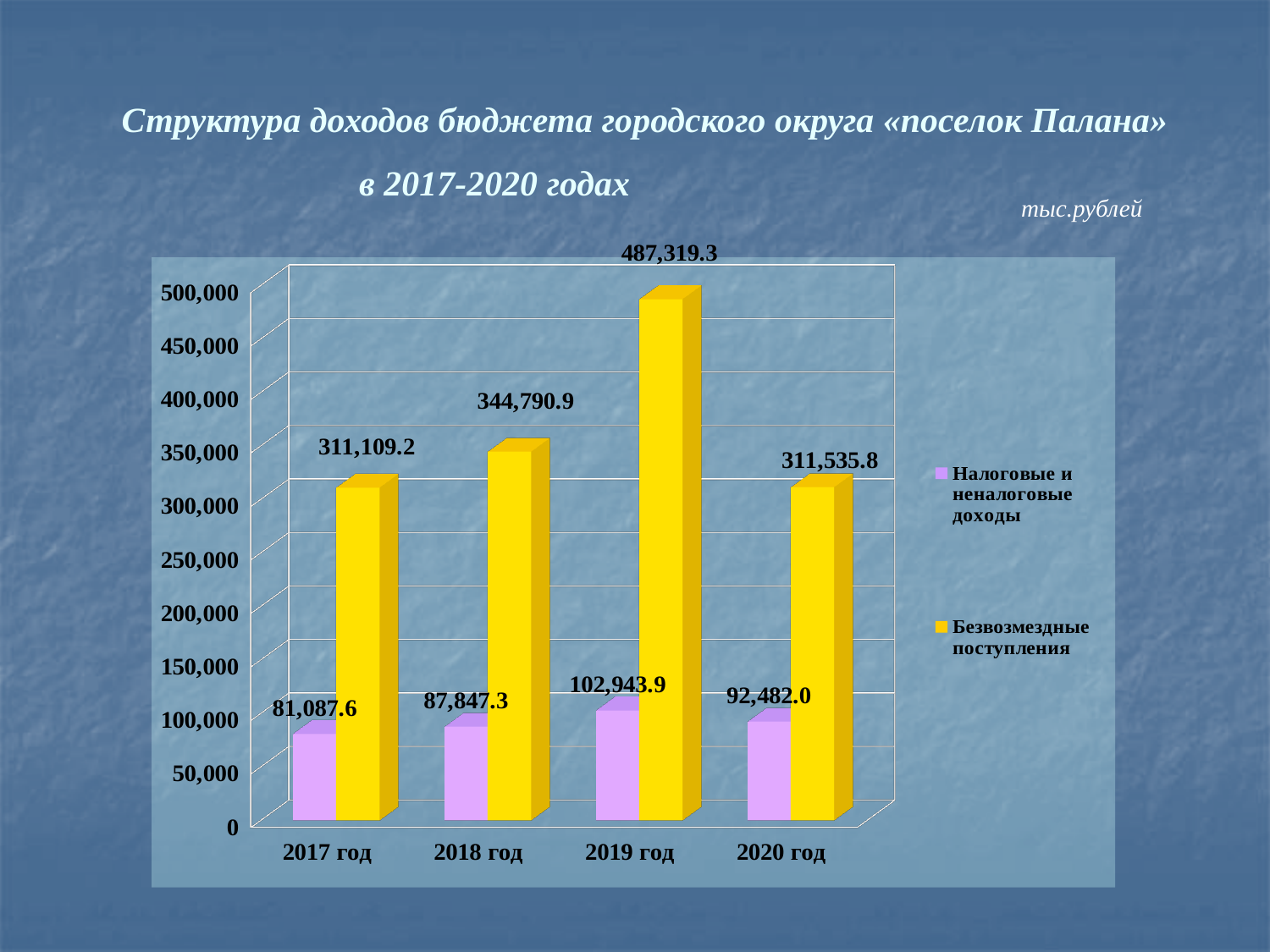
How many years are shown on the x axis? 4 What kind of chart is shown on the slide? Bar chart What is the value of Безвозмездные поступления for 2018 год? 344,790.9 What is the difference between Налоговые и неналоговые доходы in 2019 год and 2017 год? 21,856.3 How many series does the legend list? 2 Which is larger: Налоговые и неналоговые доходы in 2018 год or in 2020 год? 2020 год In which year is Безвозмездные поступления the highest? 2019 год What is the difference between Безвозмездные поступления in 2019 год and 2018 год? 142,528.4 What is the value of Безвозмездные поступления for 2019 год? 487,319.3 What is the value of Налоговые и неналоговые доходы for 2020 год? 92,482.0 What is the value of Налоговые и неналоговые доходы for 2017 год? 81,087.6 In which year is Налоговые и неналоговые доходы the lowest? 2017 год